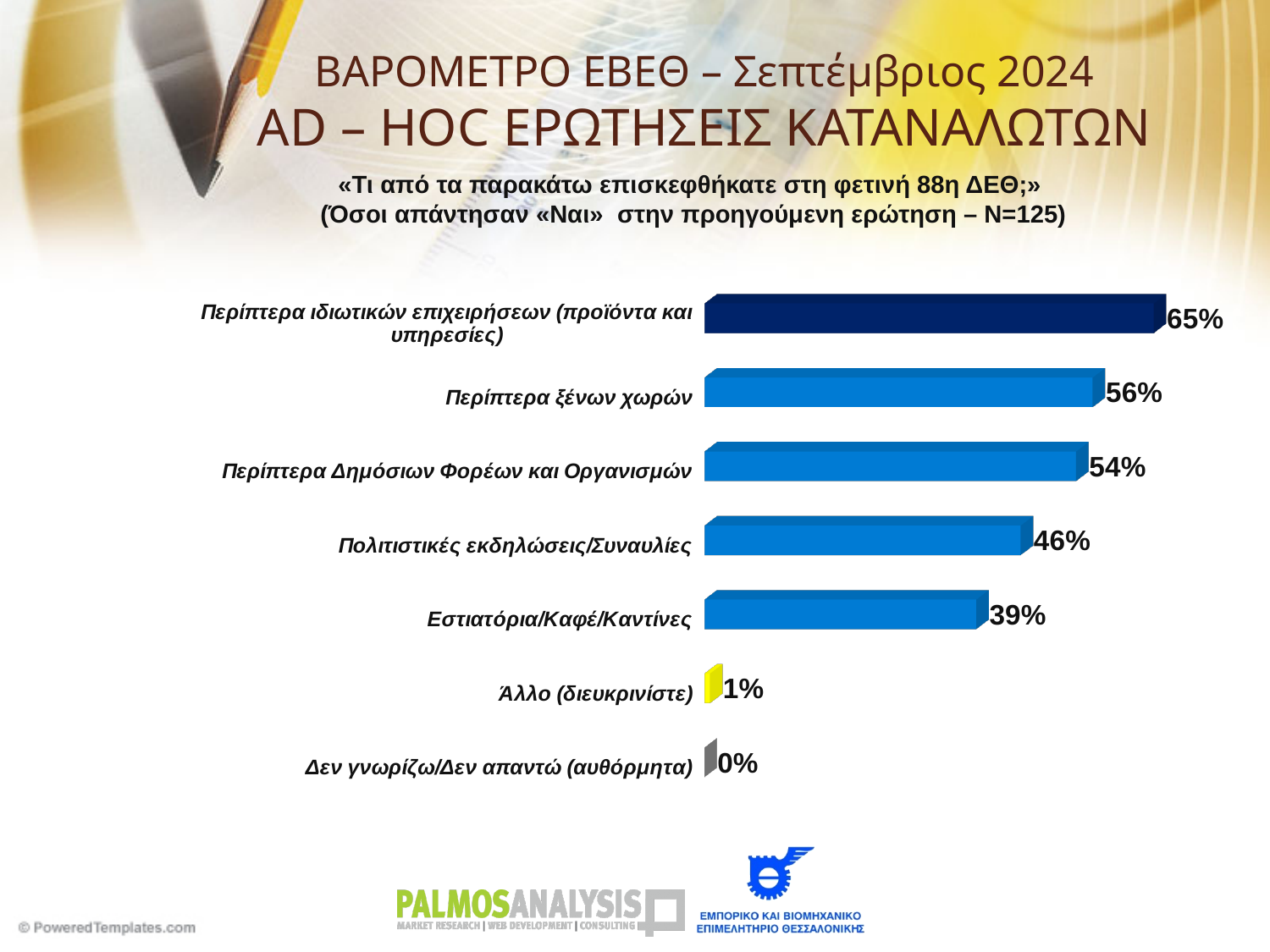
Which category has the lowest value? Δεν γνωρίζω/Δεν απαντώ (αυθόρμητα) Which is larger, the value for Περίπτερα ξένων χωρών or the value for Πολιτιστικές εκδηλώσεις/Συναυλίες? Περίπτερα ξένων χωρών What is the value for Άλλο (διευκρινίστε)? 1% What is the difference between the values for Περίπτερα ιδιωτικών επιχειρήσεων (προϊόντα και υπηρεσίες) and Περίπτερα Δημόσιων Φορέων και Οργανισμών? 11% What kind of chart is shown on the slide? bar chart How many categories are shown in the chart? 7 What is the sample size (N) stated in the chart subtitle? N=125 What is the value for Πολιτιστικές εκδηλώσεις/Συναυλίες? 46% What is the value for Περίπτερα ξένων χωρών? 56% What is the value for Εστιατόρια/Καφέ/Καντίνες? 39% What is the difference between the values for Πολιτιστικές εκδηλώσεις/Συναυλίες and Εστιατόρια/Καφέ/Καντίνες? 7% Which category has the highest value? Περίπτερα ιδιωτικών επιχειρήσεων (προϊόντα και υπηρεσίες)